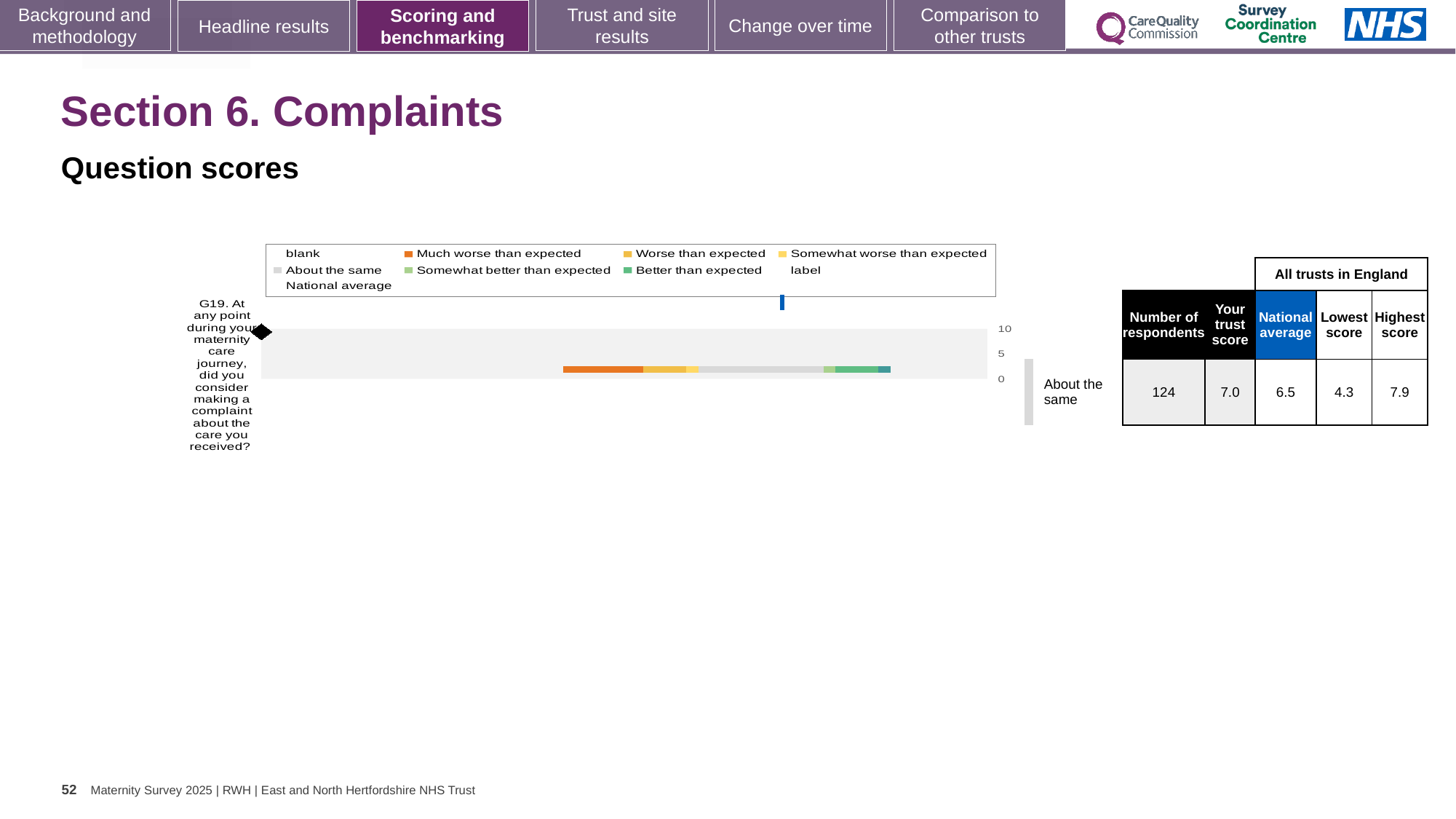
What is the national average for question G19 shown in the table beside the chart? 6.5 What is the highest score among all trusts in England for question G19? 7.9 Which legend entry is shown in orange in the chart? Much worse than expected What is the lowest score among all trusts in England for question G19? 4.3 What kind of chart is shown on the slide for question G19? bar chart What is the trust's score for question G19 shown in the table beside the chart? 7.0 What is the difference between the highest score and the lowest score for question G19? 3.6 Which is larger for question G19: the trust's score or the national average? the trust's score What benchmark category is shown for question G19 next to the chart? About the same By how much does the trust's score for question G19 exceed the national average? 0.5 According to the table beside the chart, how many respondents answered question G19? 124 How many survey questions are plotted in the chart? 1